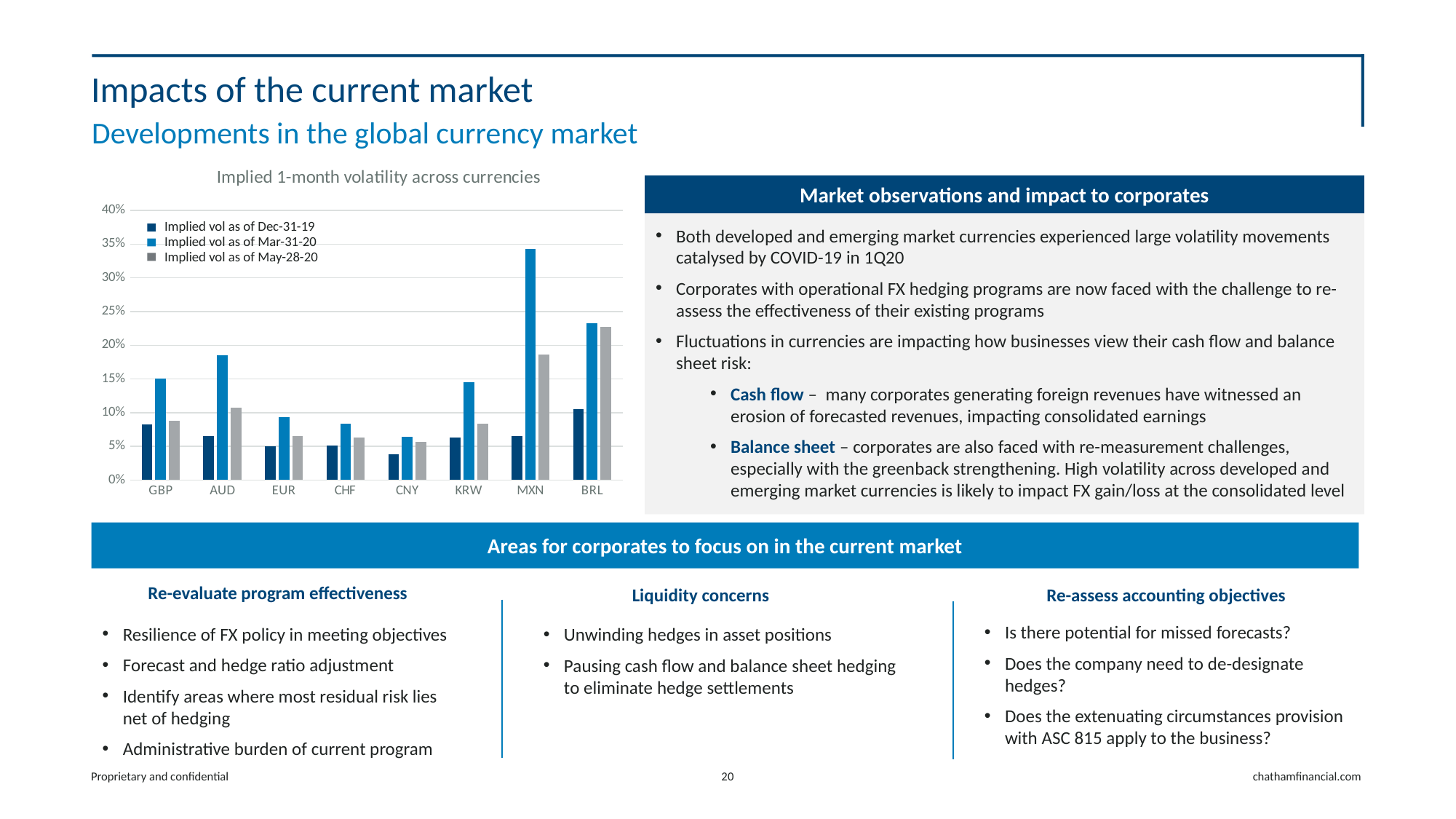
Which currency has the highest implied vol as of Dec-31-19? BRL Which currency has the lowest implied vol as of Mar-31-20? CNY Is the implied vol as of Mar-31-20 for CNY greater or less than 10%? less How many series does the legend of the implied volatility chart list? 3 Is the implied vol as of Mar-31-20 for MXN greater or less than 30%? greater What is the title of the chart on the slide? Implied 1-month volatility across currencies Is the implied vol as of Mar-31-20 for BRL greater or less than 20%? greater Which currency has the highest implied vol as of Mar-31-20? MXN Which currency has the lowest implied vol as of Dec-31-19? CNY Which is larger: the implied vol as of Mar-31-20 for GBP or for AUD? AUD How many currencies are shown on the x axis of the implied volatility chart? 8 What kind of chart is used to show implied 1-month volatility across currencies? Bar chart